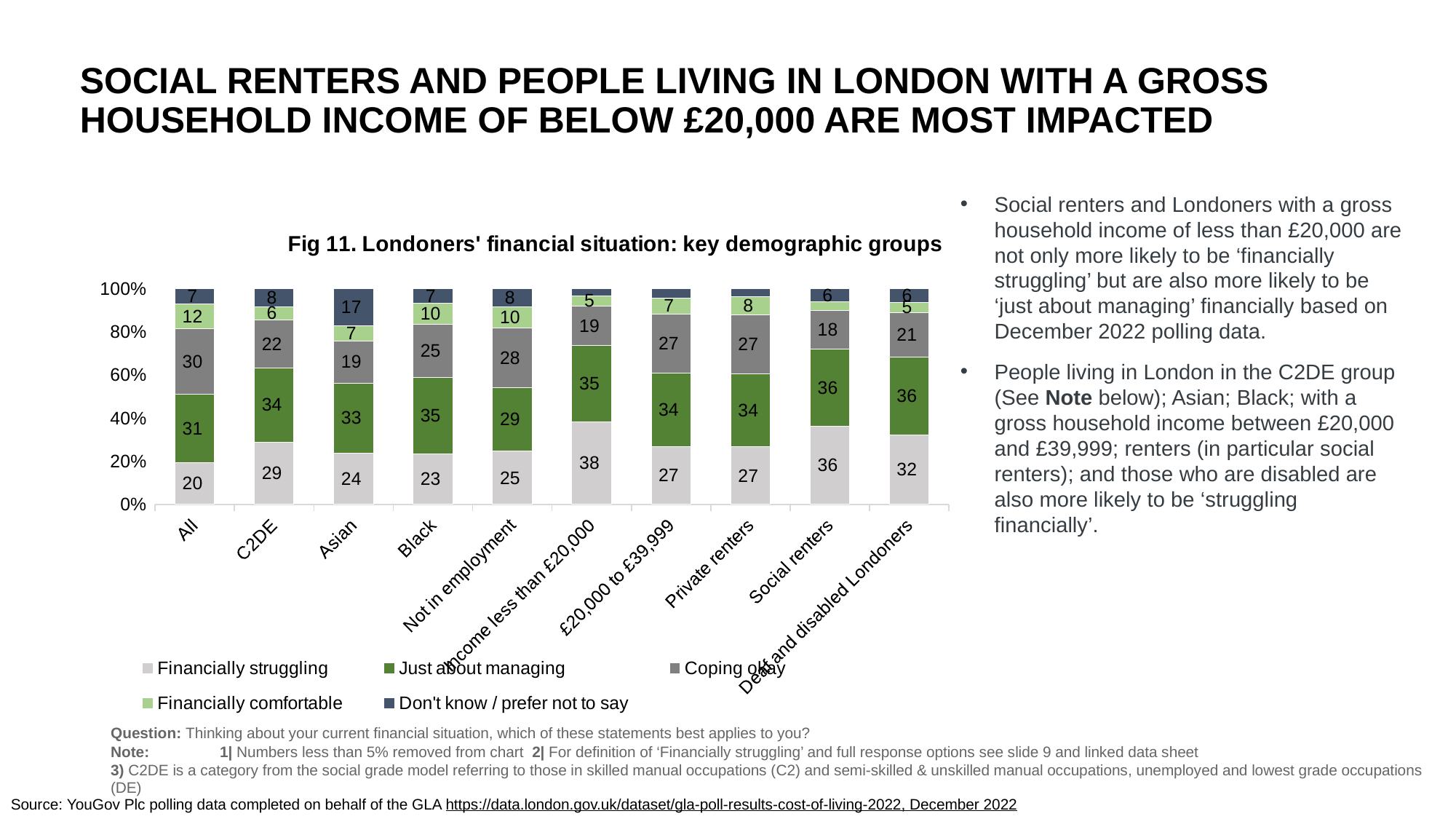
Which group has the highest 'Don't know / prefer not to say' value? Asian Which demographic group has the highest 'Financially struggling' value? Income less than £20,000 What is the 'Just about managing' value for the Black group? 35 Which has a larger 'Coping okay' value, All or C2DE? All What is the difference between the 'Financially struggling' values for Social renters and All? 16 What is the difference between the 'Financially comfortable' values for All and Income less than £20,000? 7 How many series does the legend list? 5 How many demographic groups are shown on the x axis? 10 What percentage of Londoners with an income less than £20,000 are 'Financially struggling'? 38 Which demographic group has the lowest 'Financially struggling' value? All What kind of chart is shown on the slide? Stacked bar chart What is the 'Don't know / prefer not to say' value for the Asian group? 17